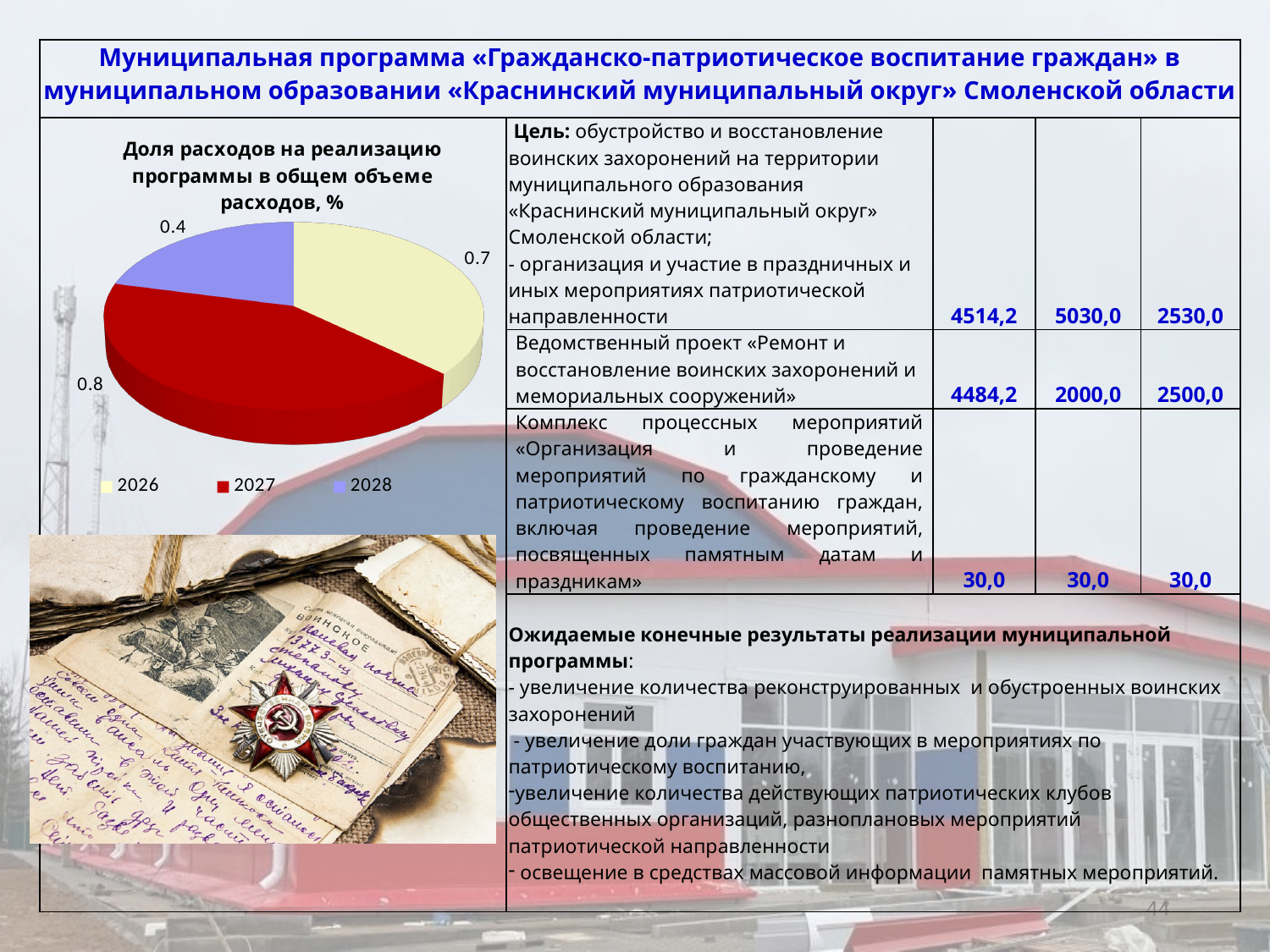
Which year has the smallest slice in the pie chart? 2028 Which year has the largest slice in the pie chart? 2027 What colour is the slice for 2027 in the pie chart? Red What type of chart is shown on the slide? Pie chart What is the value shown for 2028 in the pie chart? 0.4 Which is larger in the pie chart, the value for 2026 or the value for 2028? 2026 How many slices does the pie chart have? 3 What is the difference between the values for 2026 and 2028 in the pie chart? 0.3 What is the title of the pie chart? Доля расходов на реализацию программы в общем объеме расходов, % What is the value shown for 2027 in the pie chart? 0.8 What is the value shown for 2026 in the pie chart? 0.7 What is the difference between the values for 2027 and 2028 in the pie chart? 0.4